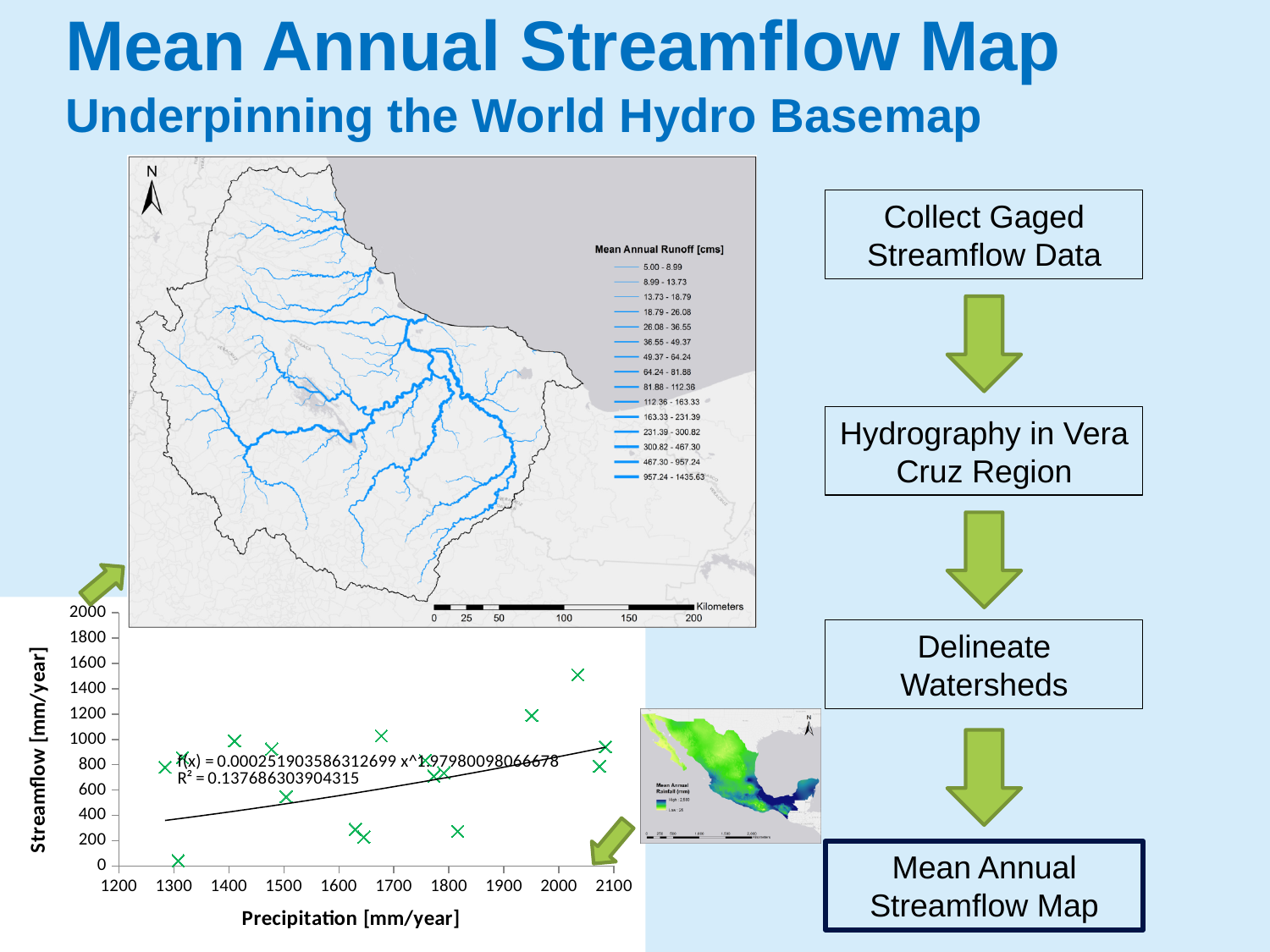
Does the fitted trendline on the scatter chart rise or fall as precipitation increases? rise What is the maximum value shown on the y axis of the scatter chart? 2000 Is the precipitation of the point with the highest streamflow on the scatter chart greater or less than 2000 mm/year? greater What kind of chart is shown at the bottom left of the slide? scatter chart What R² value is printed on the scatter chart? R² = 0.137686303904315 Is the highest streamflow value plotted on the scatter chart greater or less than 1400 mm/year? greater Is the streamflow of the point with the lowest precipitation on the scatter chart greater or less than 600 mm/year? greater What is the label of the x axis of the scatter chart? Precipitation [mm/year] What is the label of the y axis of the scatter chart? Streamflow [mm/year]